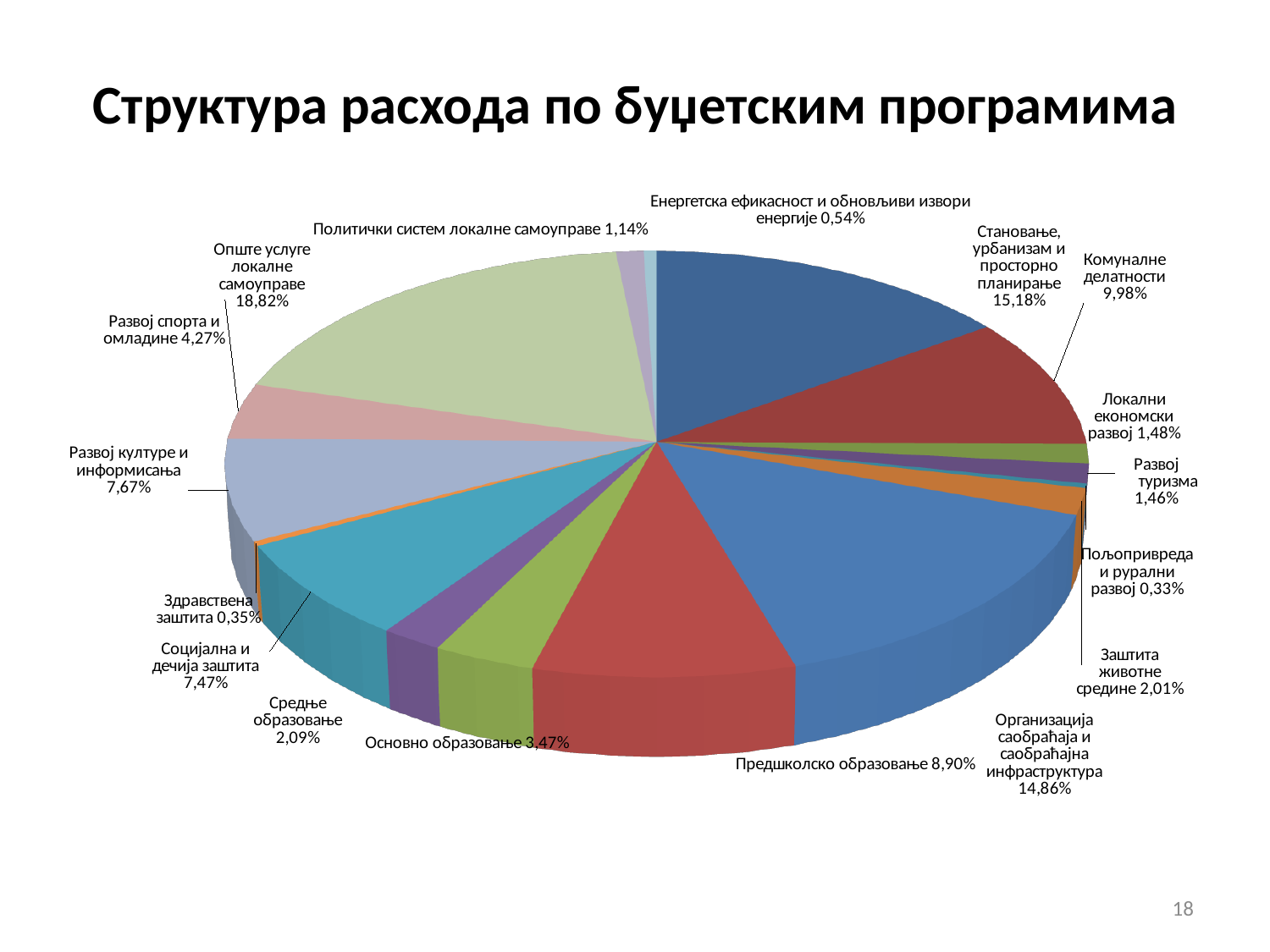
Which budget programme has the largest share of expenditure? Опште услуге локалне самоуправе What percentage is shown for Здравствена заштита? 0,35% Which has a larger share: Комуналне делатности or Предшколско образовање? Комуналне делатности What is the title of the chart? Структура расхода по буџетским програмима Which budget programme has the smallest share of expenditure? Пољопривреда и рурални развој What percentage is shown for Предшколско образовање? 8,90% How many budget programmes (slices) are shown in the pie chart? 17 What is the value for Организација саобраћаја и саобраћајна инфраструктура? 14,86% What type of chart is shown on the slide? Pie chart Which has a larger share: Основно образовање or Средње образовање? Основно образовање What is the difference in percentage points between Опште услуге локалне самоуправе and Становање, урбанизам и просторно планирање? 3,64 What share of expenditure goes to Опште услуге локалне самоуправе? 18,82%